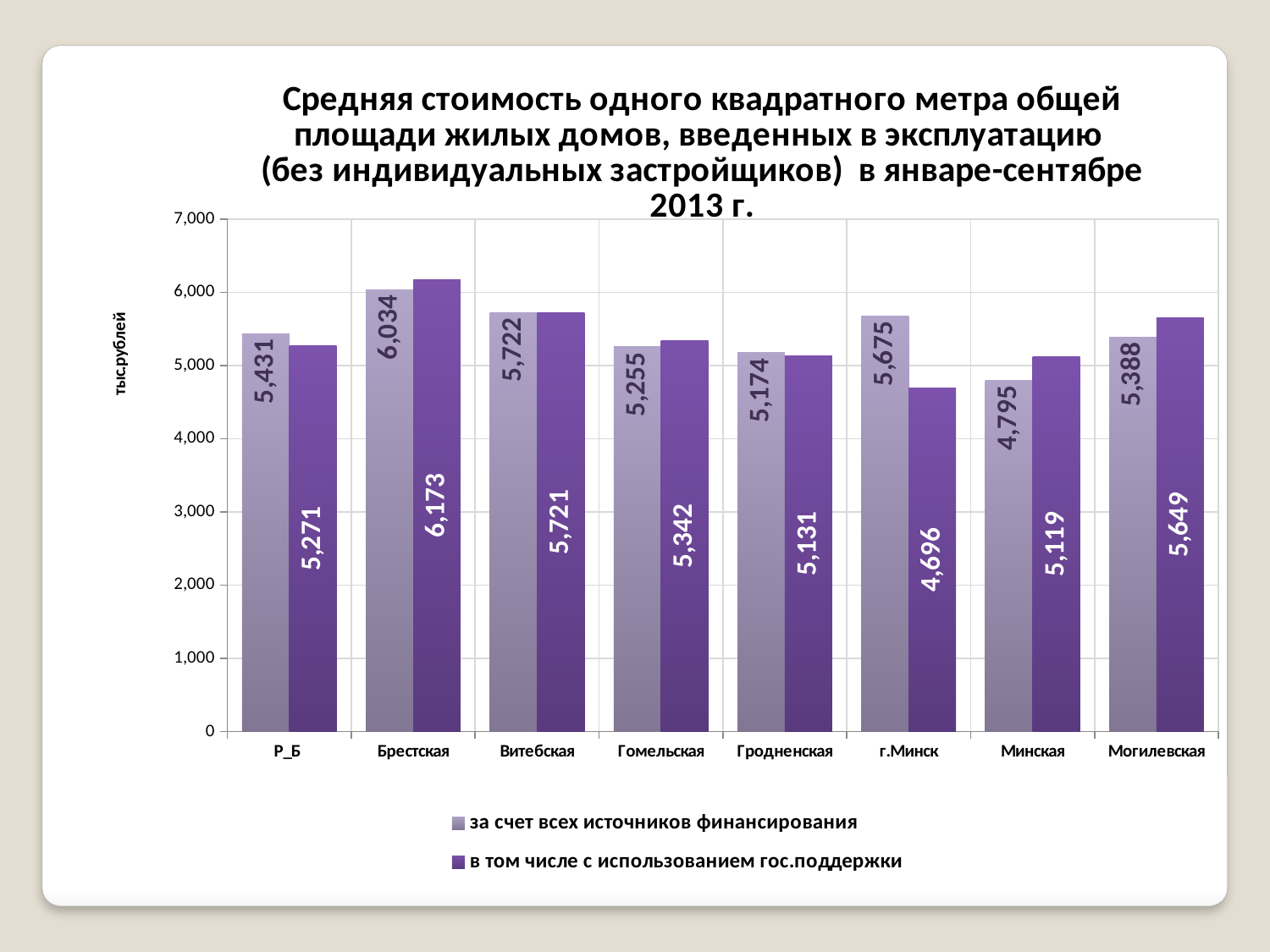
How many series does the legend list? 2 What kind of chart is shown on the slide? bar chart What is the value for Могилевская in the series 'в том числе с использованием гос.поддержки'? 5,649 Which category has the lowest value in the series 'в том числе с использованием гос.поддержки'? г.Минск What is the difference between the two series values for г.Минск? 979 Is the value for Минская in the series 'за счет всех источников финансирования' greater or less than 5,000? less What is the value for г.Минск in the series 'в том числе с использованием гос.поддержки'? 4,696 For Гомельская, which series has the larger value: 'за счет всех источников финансирования' or 'в том числе с использованием гос.поддержки'? в том числе с использованием гос.поддержки How many categories are shown on the x axis? 8 What is the difference between the values for Брестская and Минская in the series 'за счет всех источников финансирования'? 1,239 Which category has the highest value in the series 'за счет всех источников финансирования'? Брестская What is the value for Брестская in the series 'за счет всех источников финансирования'? 6,034